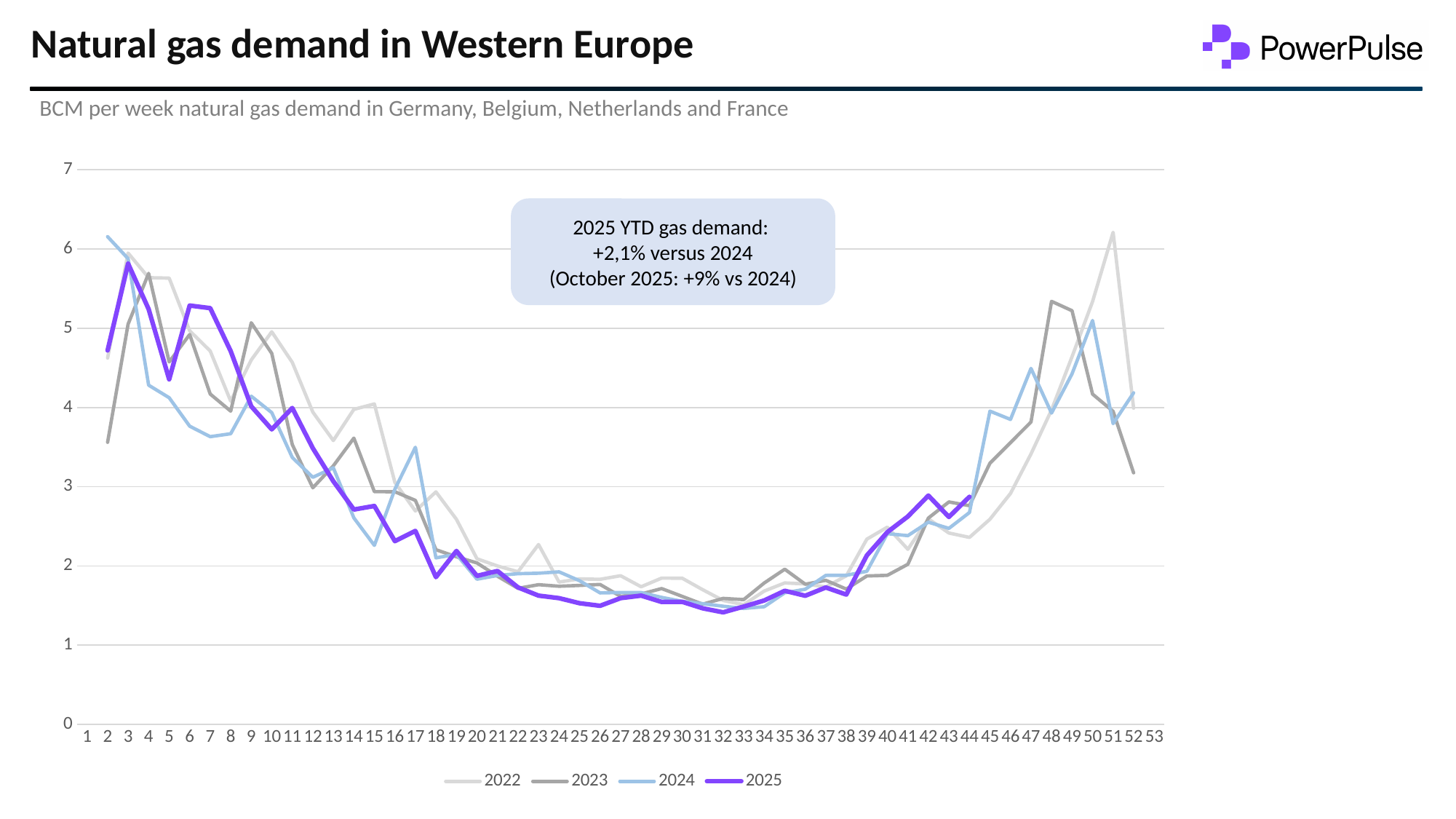
How many week numbers are shown along the x axis? 53 Which series has the highest value in week 51? 2022 Which series has the lowest value in week 2? 2023 According to the annotation box, by what percentage is 2025 YTD gas demand up versus 2024? +2,1% How many series does the legend list? 4 Is the value for 2025 in week 32 greater or less than 2? less Is the value for 2024 in week 15 greater or less than 3? less In week 2, which is larger: the value for 2024 or the value for 2023? 2024 Is the value for 2025 in week 3 greater or less than 5? greater Does the 2025 line rise or fall from week 3 to week 18? Fall What kind of chart is shown on the slide? Line chart